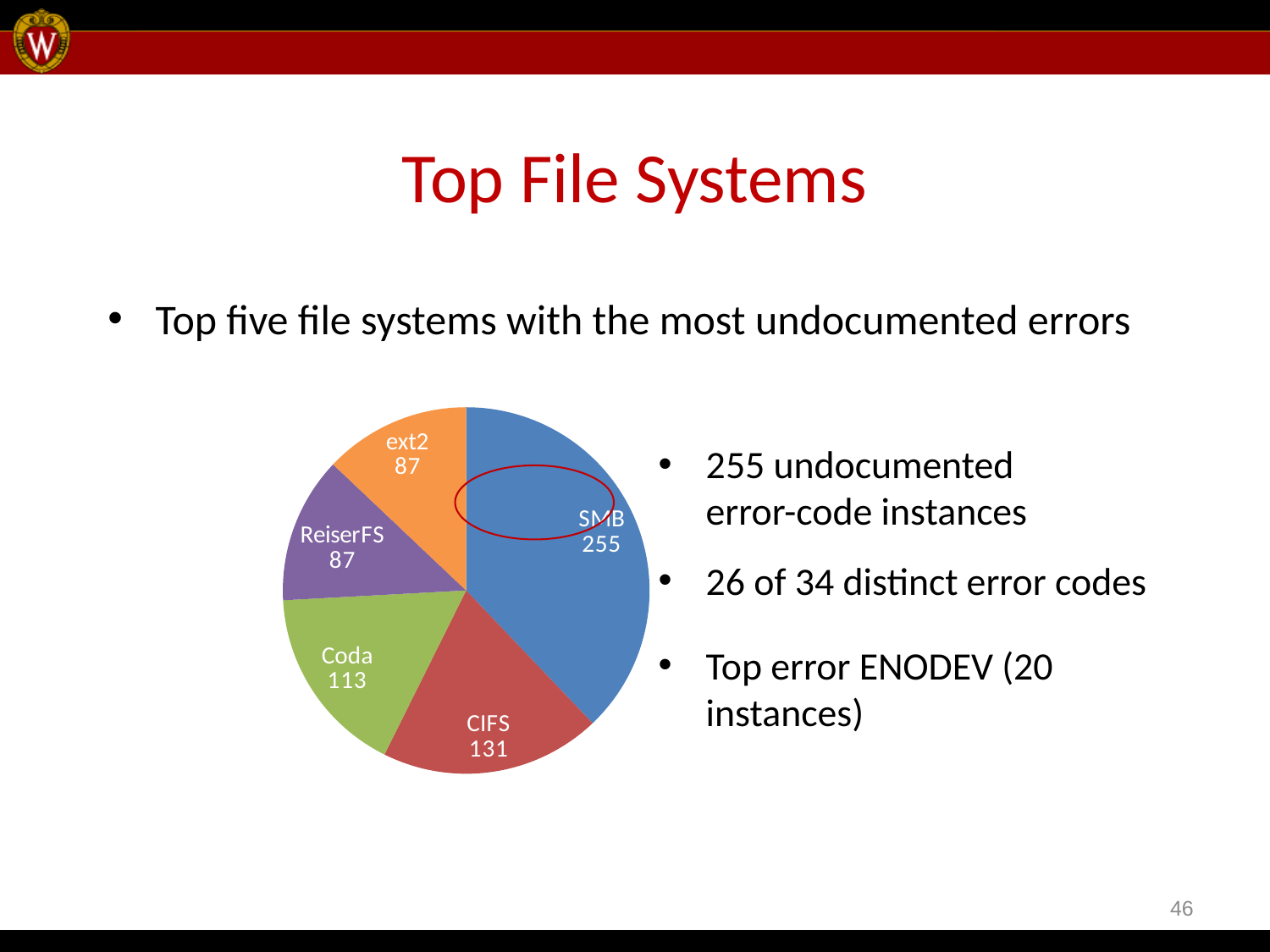
What is the difference between the CIFS value and the Coda value? 18 What is the value shown for Coda in the pie chart? 113 Which slice of the pie chart is highlighted with a red oval? SMB What type of chart is shown on the slide? pie chart What is the value shown for SMB in the pie chart? 255 What is the value shown for ReiserFS in the pie chart? 87 How many file systems (slices) are shown in the pie chart? 5 What is the total of all the values in the pie chart? 673 What is the value shown for CIFS in the pie chart? 131 What is the difference between the SMB value and the CIFS value? 124 Which has a larger value, CIFS or Coda? CIFS Which file system has the largest slice in the pie chart? SMB